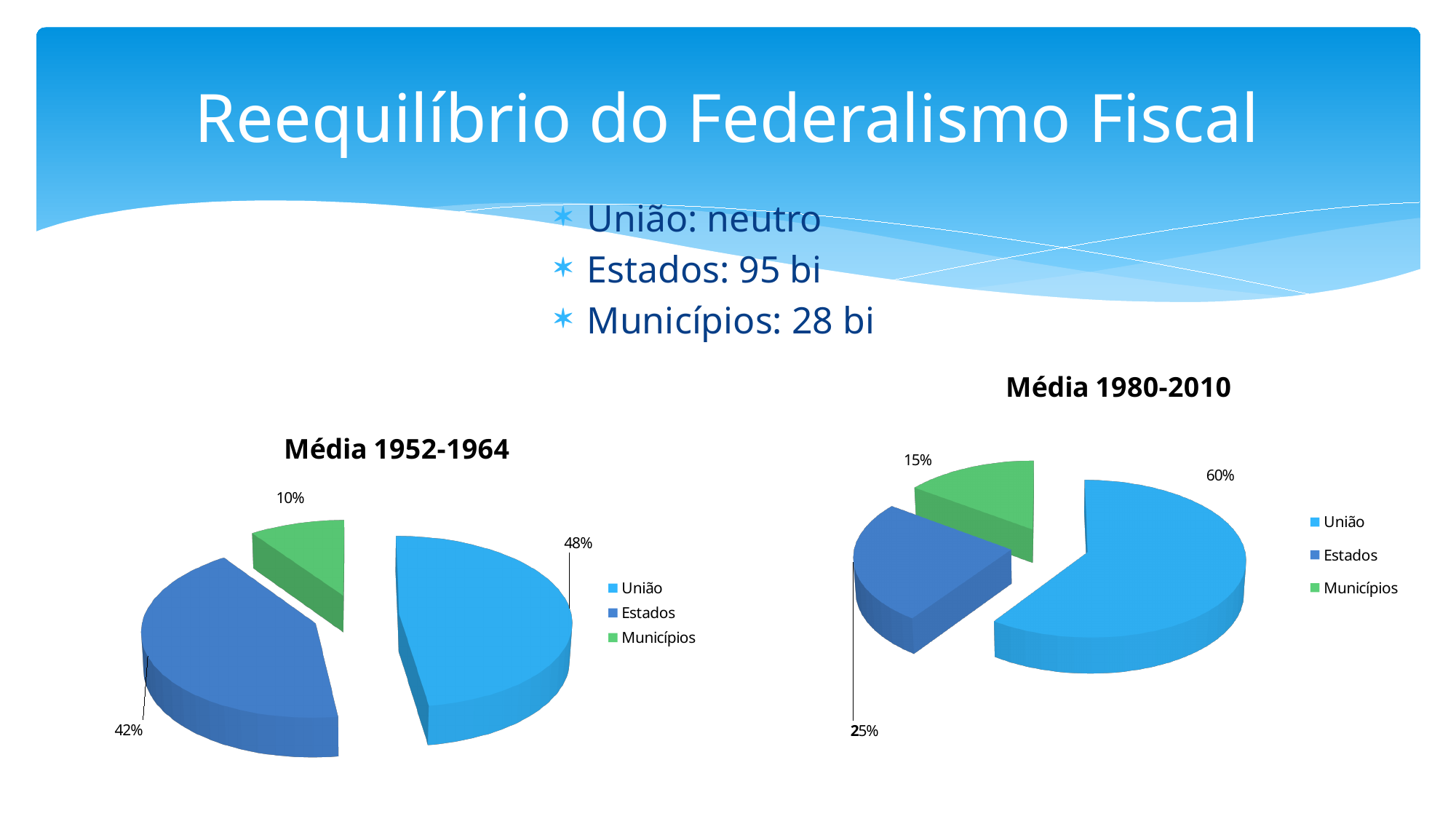
In the 'Média 1980-2010' chart, what share does União have? 60% How many entries does the legend of the 'Média 1980-2010' chart list? 3 In the 'Média 1980-2010' chart, what share does Estados have? 25% In the 'Média 1952-1964' chart, what share does União have? 48% In the 'Média 1980-2010' chart, which is larger, the Estados slice or the Municípios slice? Estados In the 'Média 1980-2010' chart, what share does Municípios have? 15% What kind of chart is the 'Média 1952-1964' chart? Pie chart In the 'Média 1980-2010' chart, which category has the largest slice? União In the 'Média 1952-1964' chart, which category has the smallest slice? Municípios In the 'Média 1952-1964' chart, what is the difference between the União and Estados shares? 6% In the 'Média 1952-1964' chart, what share does Municípios have? 10% In the 'Média 1952-1964' chart, what share does Estados have? 42%